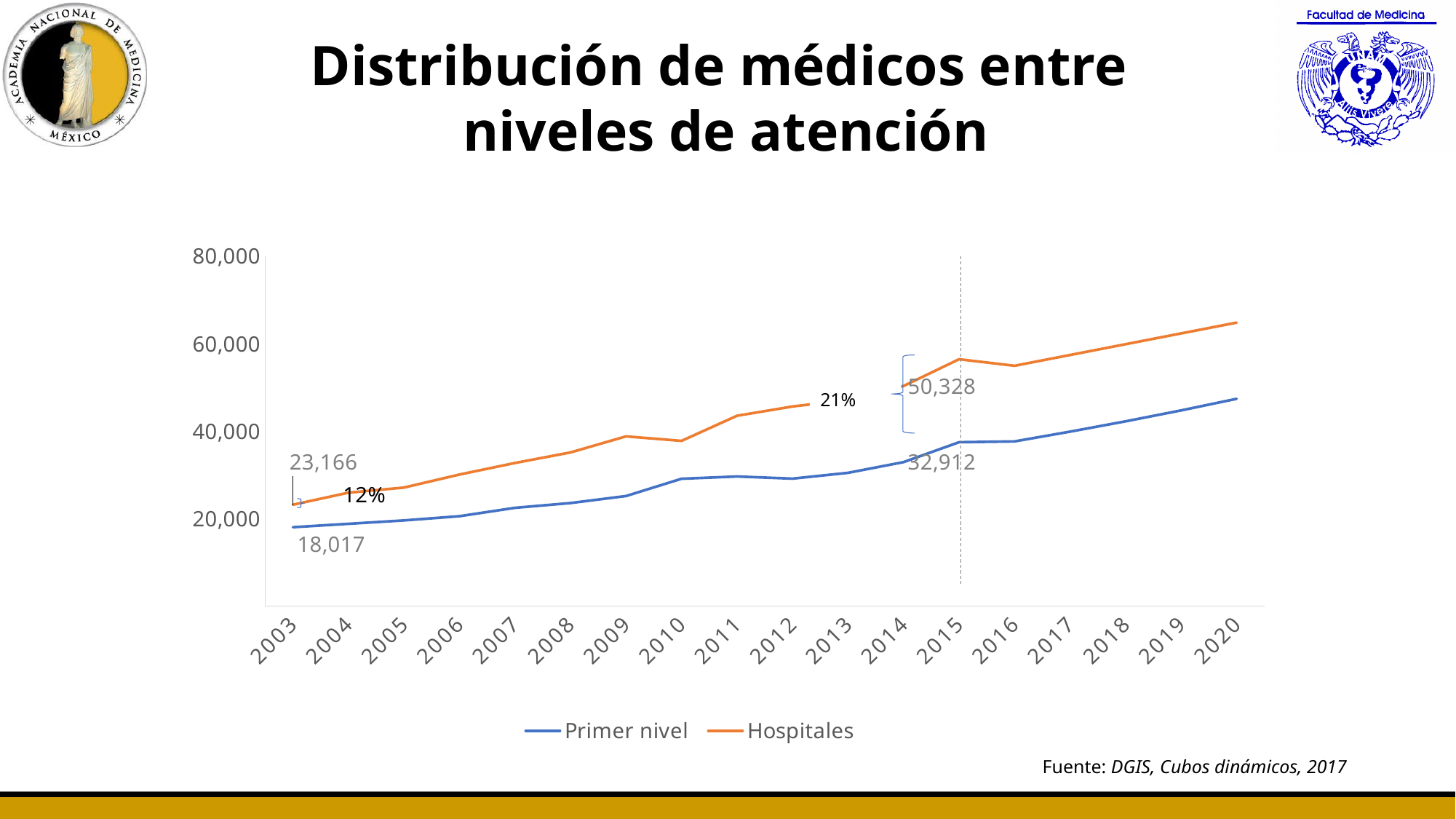
What is the labelled value for Primer nivel in 2003? 18,017 What type of chart is shown on the slide? line chart What is the labelled value for Primer nivel in 2014? 32,912 Which series has the higher value in 2020, Primer nivel or Hospitales? Hospitales What is the labelled value for Hospitales in 2003? 23,166 What are the two series named in the legend? Primer nivel and Hospitales How many series does the legend list? 2 Is the value for Hospitales in 2020 greater or less than 60,000? greater How many years are shown on the x axis? 18 Do the values for Primer nivel generally rise or fall from 2003 to 2020? rise What is the difference between the labelled Hospitales and Primer nivel values in 2014? 17,416 What is the labelled value for Hospitales in 2014? 50,328